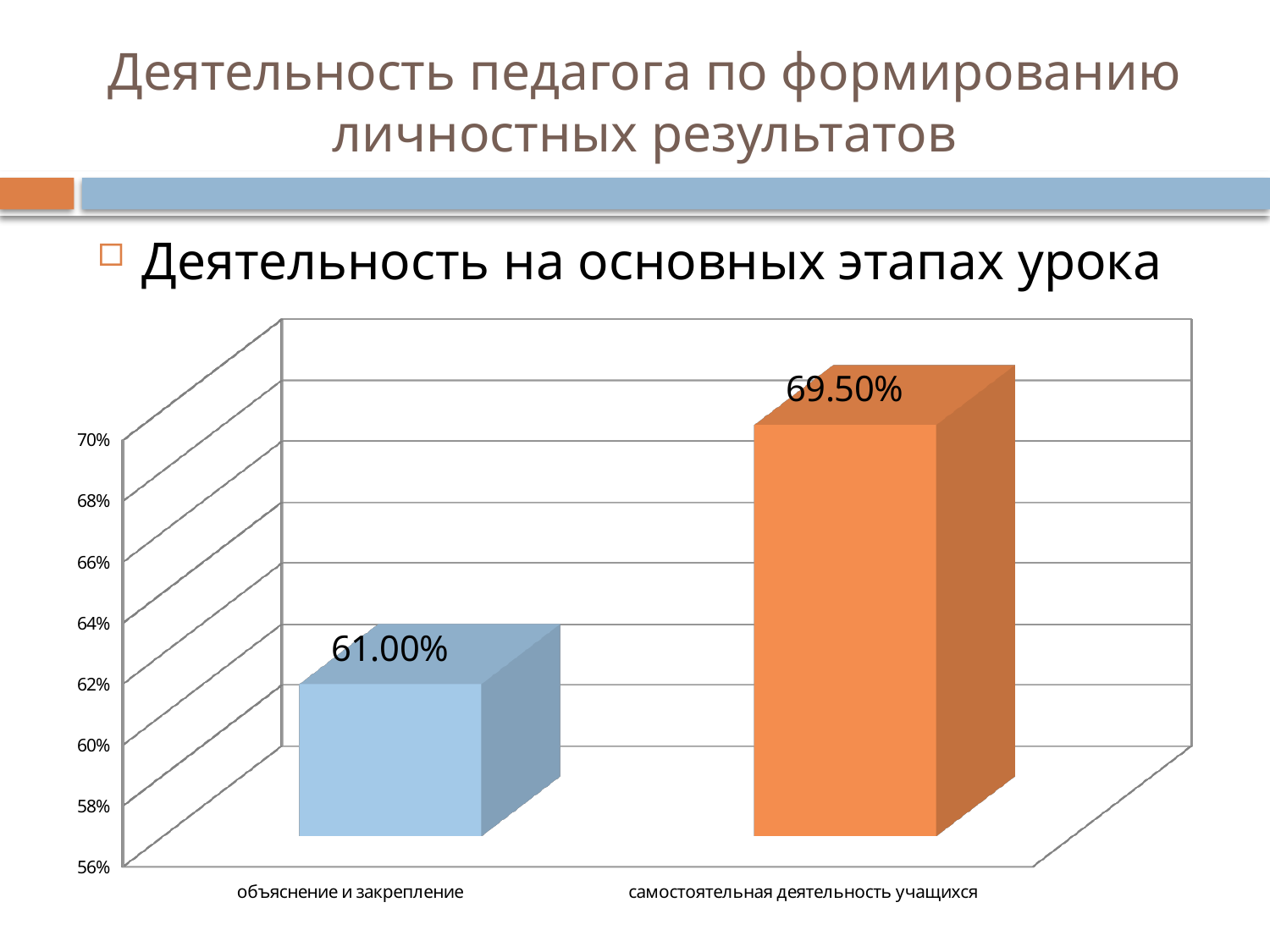
Is the value for "объяснение и закрепление" greater or less than 64%? less Which is larger: the value for "объяснение и закрепление" or for "самостоятельная деятельность учащихся"? самостоятельная деятельность учащихся What is the value for "объяснение и закрепление"? 61.00% What colour is the bar for "самостоятельная деятельность учащихся"? orange Is the value for "самостоятельная деятельность учащихся" greater or less than 66%? greater What is the value for "самостоятельная деятельность учащихся"? 69.50% What is the difference between the values for "самостоятельная деятельность учащихся" and "объяснение и закрепление"? 8.50% Which category has the lowest value? объяснение и закрепление Do the values rise or fall from left to right along the x axis? rise Which category has the highest value? самостоятельная деятельность учащихся What kind of chart is shown on the slide? bar chart How many categories are shown in the chart? 2